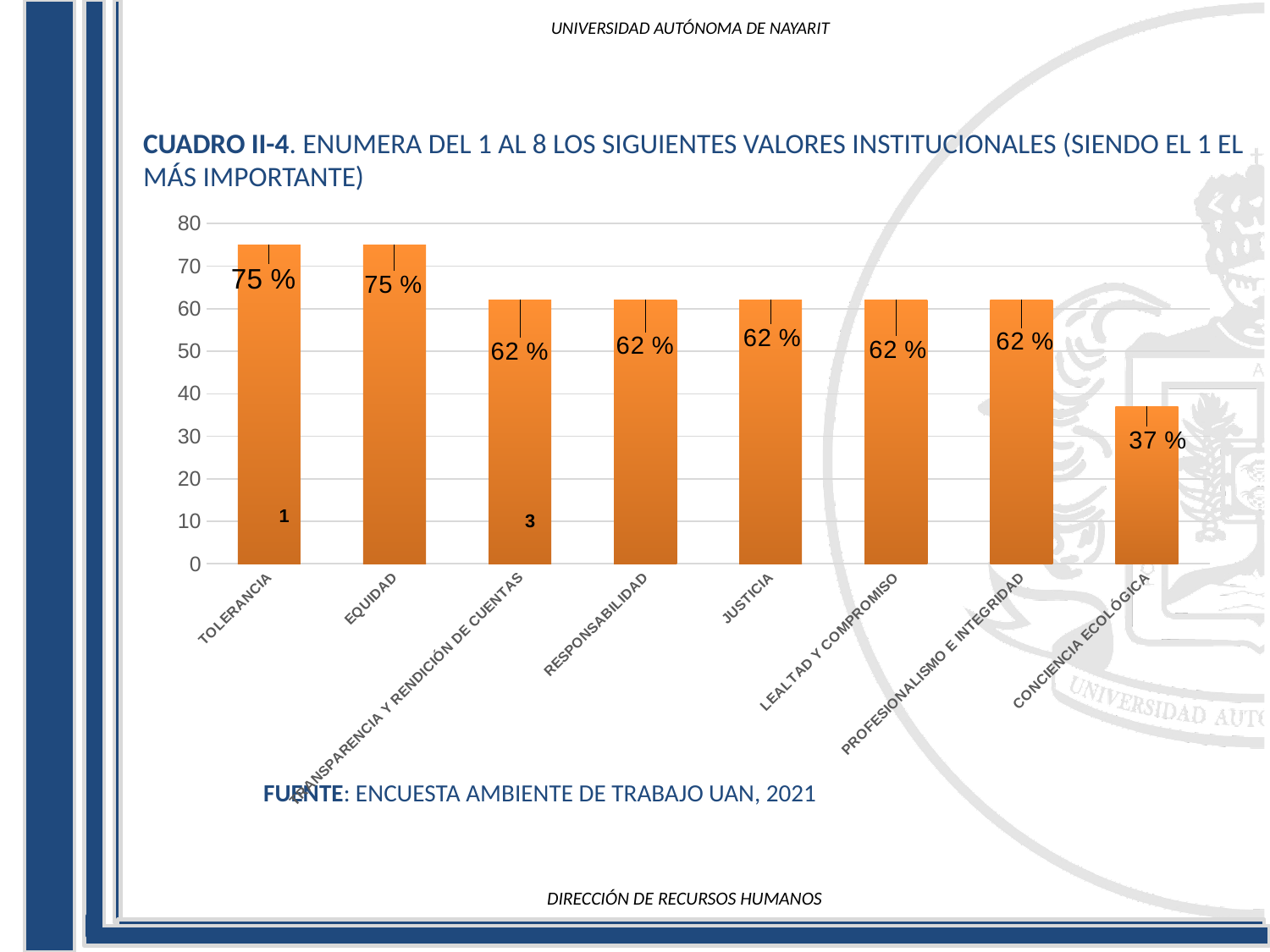
Is the value for CONCIENCIA ECOLÓGICA greater or less than 40? less What kind of chart is shown on the slide? bar chart Which is larger, the value for EQUIDAD or the value for LEALTAD Y COMPROMISO? EQUIDAD Which category has the lowest value? CONCIENCIA ECOLÓGICA What is the difference between the values for EQUIDAD and RESPONSABILIDAD? 13 % What source is cited below the chart? ENCUESTA AMBIENTE DE TRABAJO UAN, 2021 What is the value for JUSTICIA? 62 % How many categories are shown on the x axis? 8 What is the value for TOLERANCIA? 75 % What is the difference between the values for TOLERANCIA and CONCIENCIA ECOLÓGICA? 38 % What is the value for CONCIENCIA ECOLÓGICA? 37 % What is the value for EQUIDAD? 75 %